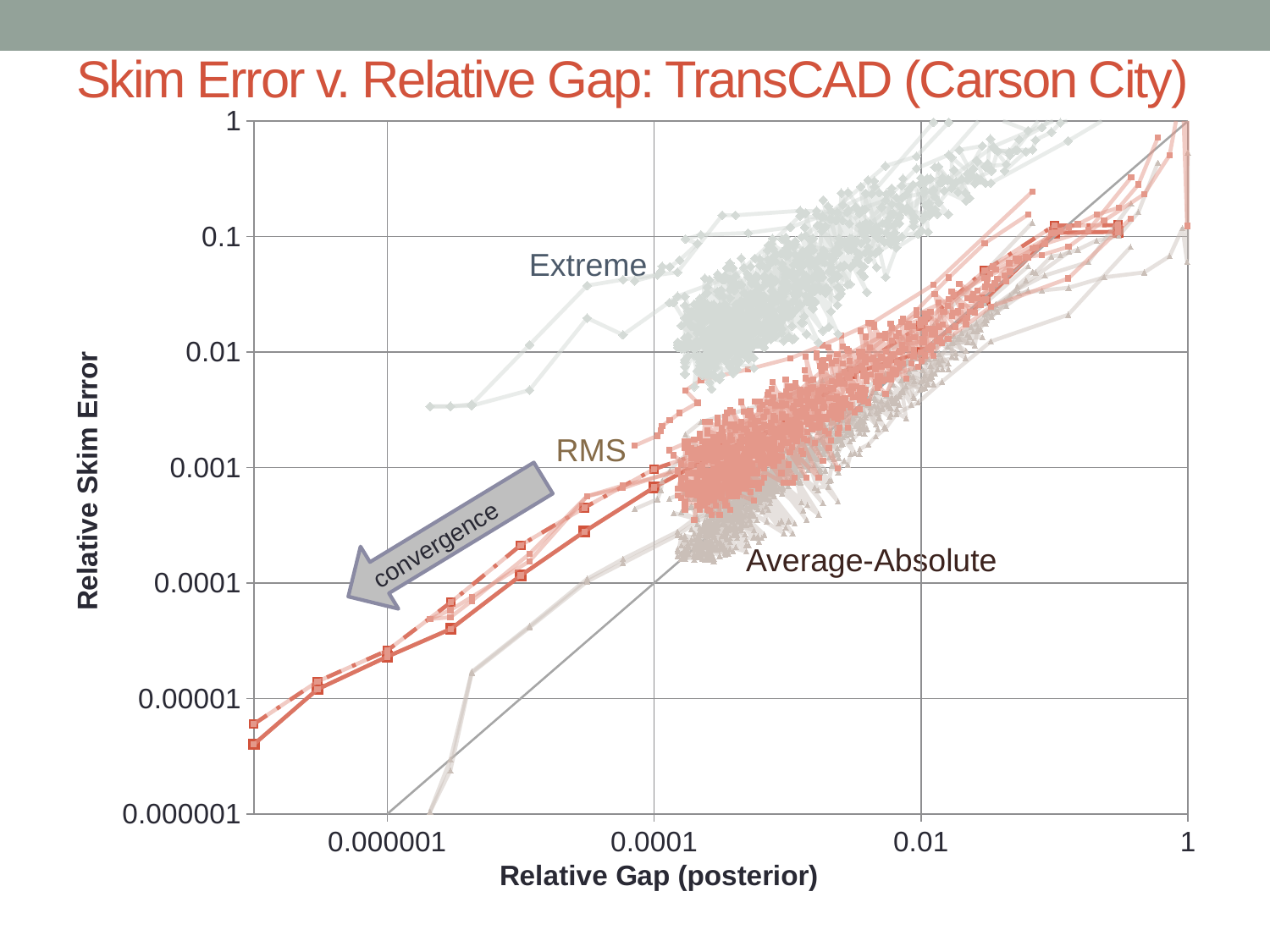
Which series has larger relative skim error values, Extreme or RMS? Extreme What is the label of the x axis? Relative Gap (posterior) Which series lies lowest on the chart, with the smallest relative skim error? Average-Absolute How many labeled data series are plotted on the chart? 3 What is the label of the y axis? Relative Skim Error What is the title of the chart? Skim Error v. Relative Gap: TransCAD (Carson City) What kind of chart is shown on the slide? scatter chart Does the relative skim error rise or fall as the relative gap increases along the x axis? rise Which series has larger relative skim error values, RMS or Average-Absolute? RMS Which series lies highest on the chart, with the largest relative skim error? Extreme